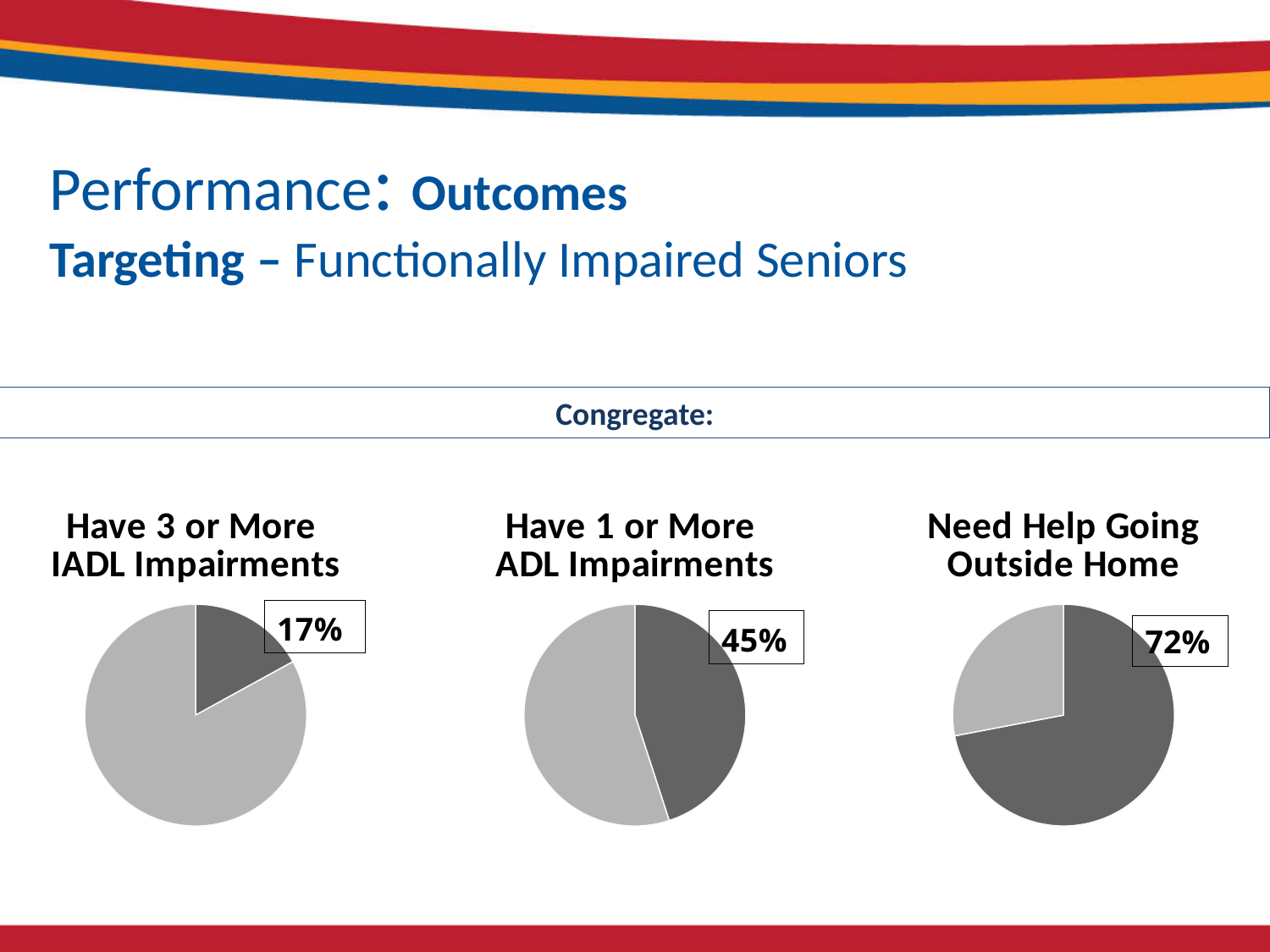
How many pie charts are shown on the slide? 3 What kind of chart is used for 'Need Help Going Outside Home'? Pie chart In the pie chart titled 'Have 1 or More ADL Impairments', what percentage is shown by the data label? 45% What is the heading in the box above the three pie charts? Congregate: What is the difference between the labelled percentage in 'Need Help Going Outside Home' and in 'Have 1 or More ADL Impairments'? 27% Which of the three pie charts shows the highest labelled percentage? Need Help Going Outside Home Which of the three pie charts shows the lowest labelled percentage? Have 3 or More IADL Impairments In the pie chart titled 'Have 3 or More IADL Impairments', what percentage is shown by the data label? 17% In the pie chart titled 'Need Help Going Outside Home', is the dark slice greater or less than half of the pie? greater Which is larger: the labelled percentage in 'Have 1 or More ADL Impairments' or in 'Have 3 or More IADL Impairments'? Have 1 or More ADL Impairments What is the difference between the labelled percentage in 'Have 1 or More ADL Impairments' and in 'Have 3 or More IADL Impairments'? 28% In the pie chart titled 'Need Help Going Outside Home', what percentage is shown by the data label? 72%